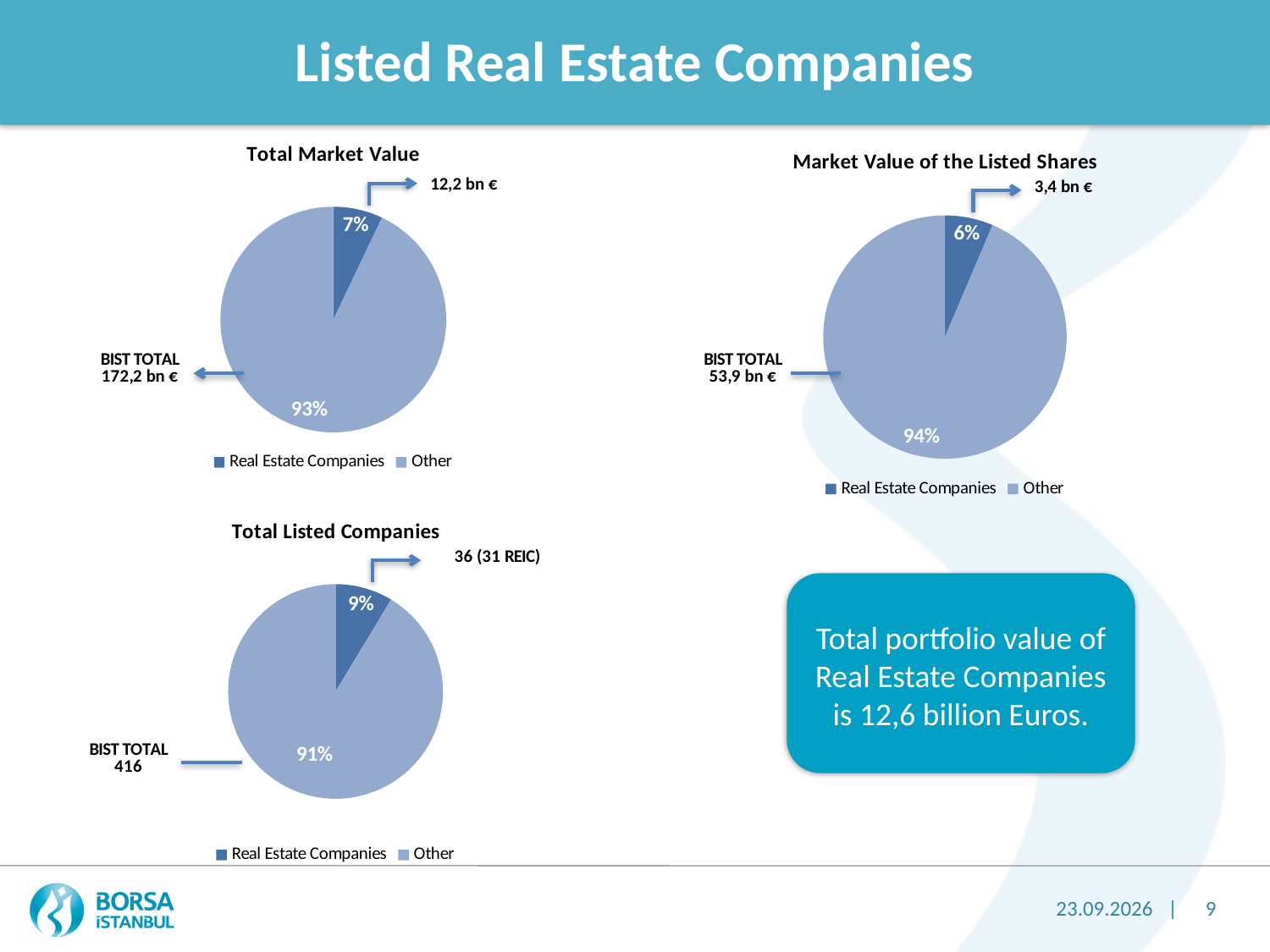
In the 'Market Value of the Listed Shares' chart, what share of the pie do Real Estate Companies hold? 6% In the 'Total Listed Companies' chart, what share of the pie does 'Other' hold? 91% In the 'Market Value of the Listed Shares' chart, what value is shown for the Real Estate Companies slice? 3,4 bn € How many entries does the legend of the 'Market Value of the Listed Shares' chart list? 2 In the 'Total Market Value' chart, which slice is larger, Real Estate Companies or Other? Other In the 'Total Market Value' chart, what share of the pie does 'Other' hold? 93% In the 'Total Market Value' chart, what is the BIST TOTAL value shown? 172,2 bn € What kind of chart is the 'Total Listed Companies' chart? Pie chart In the 'Total Listed Companies' chart, what is the BIST TOTAL value shown? 416